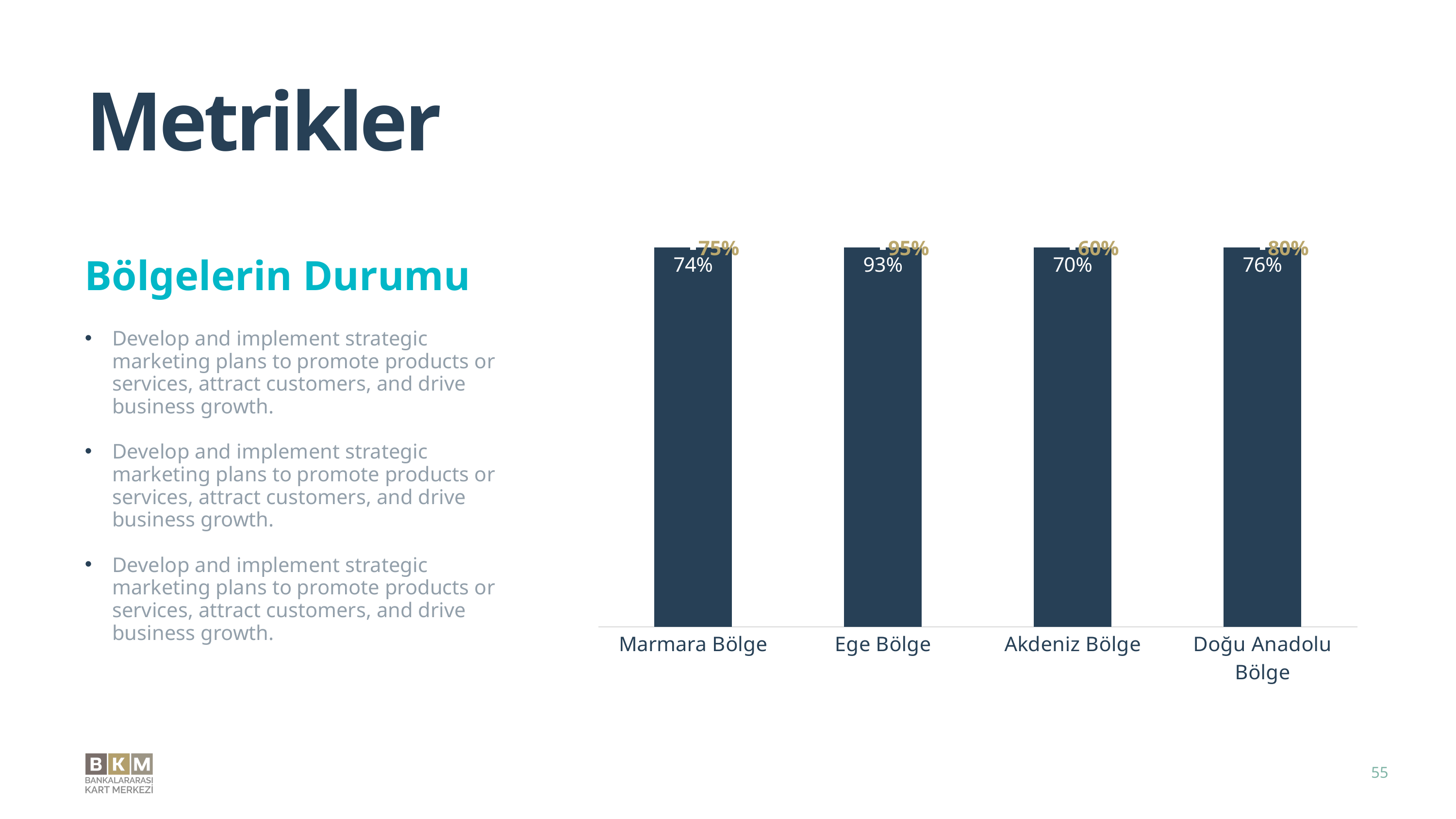
What is the difference between the white label values for Ege Bölge (93%) and Marmara Bölge (74%)? 19 percentage points Which region has the highest white data label value? Ege Bölge What is the heading shown to the left of the chart? Bölgelerin Durumu What is the white data label shown inside the Ege Bölge bar? 93% What colour are the bars in the chart? dark navy blue What kind of chart is shown on the slide? bar chart What is the white data label shown inside the Marmara Bölge bar? 74% Which has the larger white label value, Doğu Anadolu Bölge or Marmara Bölge? Doğu Anadolu Bölge How many regions (categories) are shown on the x axis of the chart? 4 What is the gold value printed above the Doğu Anadolu Bölge bar? 80% Which region has the lowest gold label value? Akdeniz Bölge What is the gold value printed above the Akdeniz Bölge bar? 60%